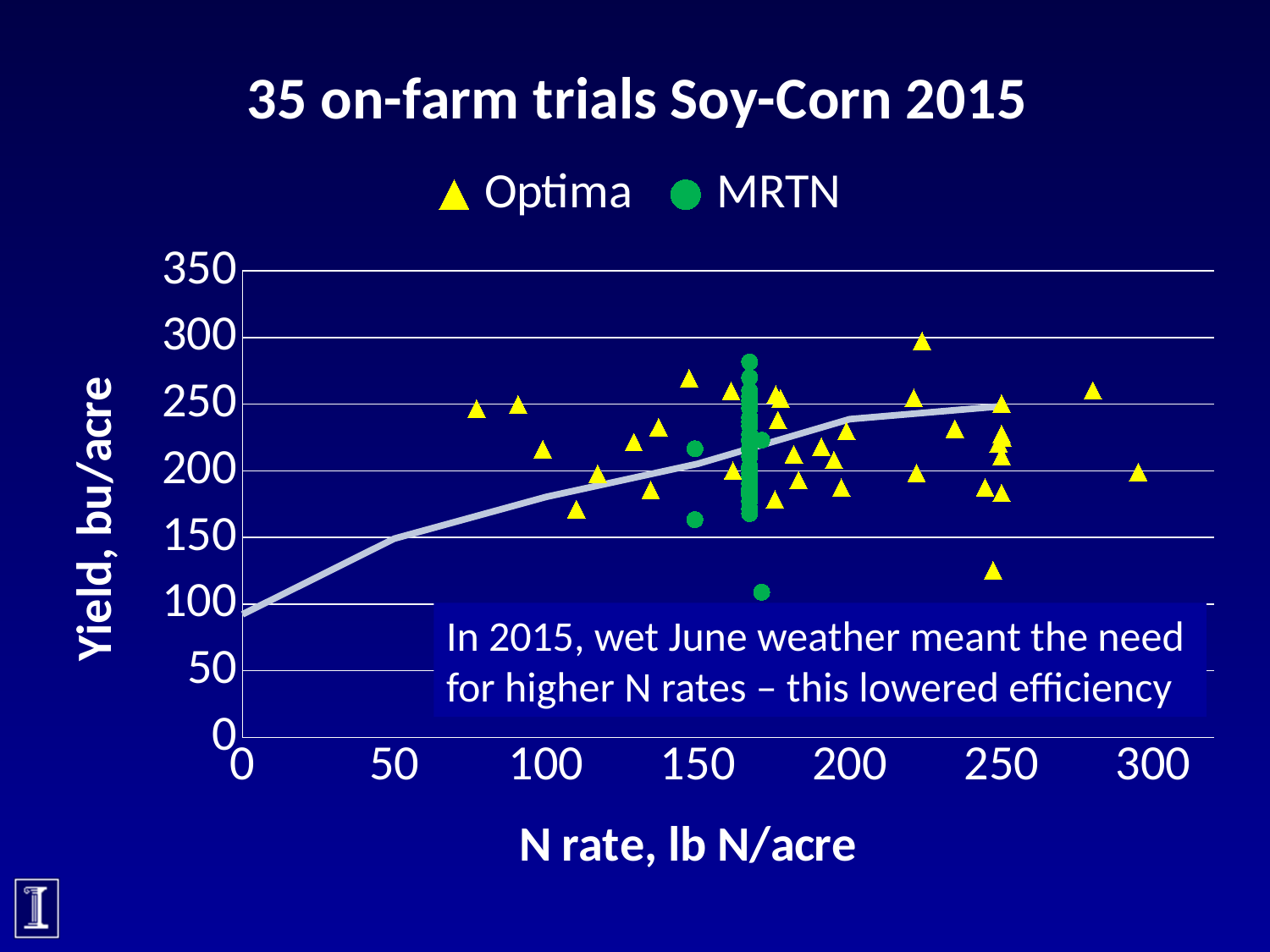
What is the label of the x axis? N rate, lb N/acre Is the highest Optima yield plotted greater or less than 250? greater Is the lowest Optima yield plotted greater or less than 150? less How many series does the legend list? 2 Is the lowest MRTN yield plotted greater or less than 150? less What is the highest value shown on the y axis? 350 What is the title of the chart? 35 on-farm trials Soy-Corn 2015 What are the two series named in the legend? Optima and MRTN Does the trend line rise or fall as the N rate increases along the x axis? Rises What kind of chart is shown on the slide? Scatter chart What is the label of the y axis? Yield, bu/acre